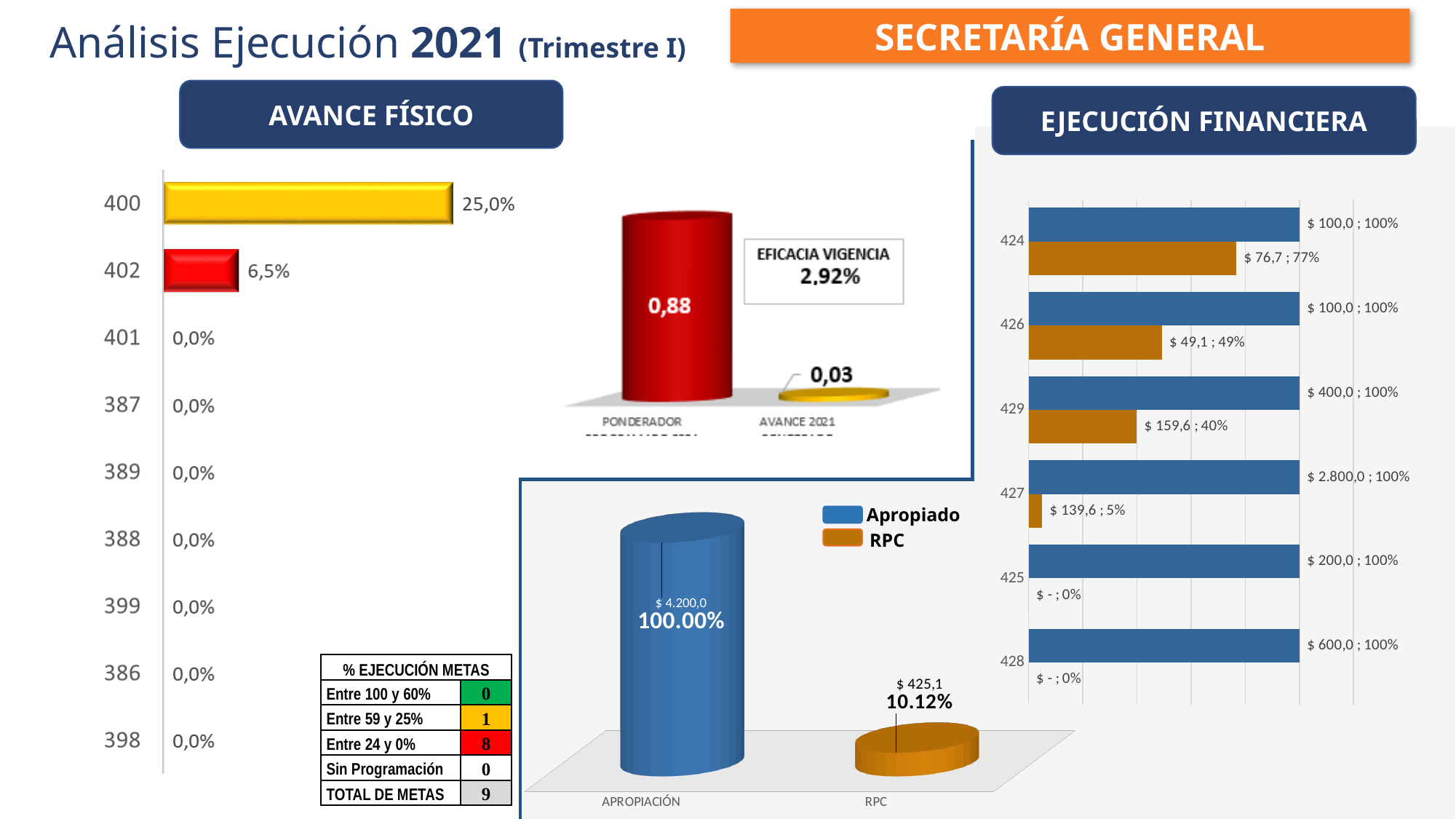
In the EJECUCIÓN FINANCIERA chart on the right, which category has the highest Apropiado value? 427 In the AVANCE FÍSICO bar chart on the left, what is the value for category 402? 6,5% In the AVANCE FÍSICO bar chart on the left, which category has the highest value? 400 In the AVANCE FÍSICO bar chart on the left, how many categories are shown? 9 In the cylinder chart in the middle of the slide, what is the value for PONDERADOR? 0,88 In the bottom-middle chart, what amount is shown for APROPIACIÓN? $ 4.200,0 In the cylinder chart in the middle of the slide, what is the value for AVANCE 2021? 0,03 In the AVANCE FÍSICO bar chart on the left, what is the value for category 400? 25,0% In the AVANCE FÍSICO bar chart on the left, what is the difference between the values for 400 and 402? 18,5% In the EJECUCIÓN FINANCIERA chart on the right, how many series does the legend list? 2 In the EJECUCIÓN FINANCIERA chart on the right, what is the RPC value for category 429? $ 159,6 ; 40% In the bottom-middle chart, what percentage is shown for RPC? 10.12%